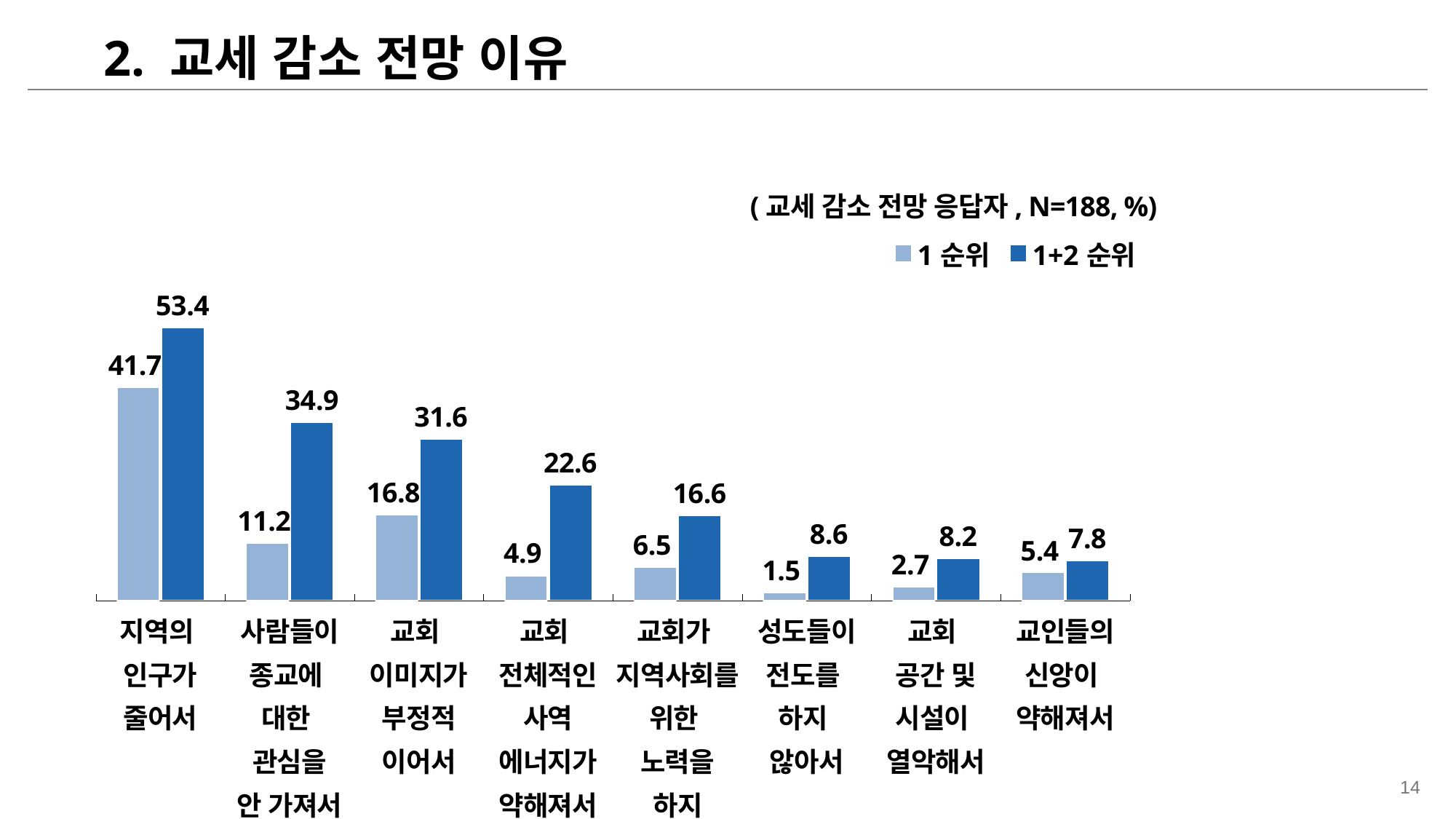
What kind of chart is shown on the slide? Bar chart Which is larger: the 1 순위 value for 교회 공간 및 시설이 열악해서 or the 1 순위 value for 교인들의 신앙이 약해져서? 교인들의 신앙이 약해져서 What is the difference between the 1+2 순위 and 1 순위 values for 사람들이 종교에 대한 관심을 안 가져서? 23.7 What is the sample size (N) stated above the chart? 188 What is the 1+2 순위 value for 교회 전체적인 사역 에너지가 약해져서? 22.6 What is the 1+2 순위 value for 지역의 인구가 줄어서? 53.4 How many series does the legend list? 2 Which category has the lowest 1 순위 value? 성도들이 전도를 하지 않아서 What is the 1 순위 value for 성도들이 전도를 하지 않아서? 1.5 How many categories are shown on the x axis? 8 Which category has the highest 1+2 순위 value? 지역의 인구가 줄어서 What is the 1 순위 value for 교회 이미지가 부정적이어서? 16.8